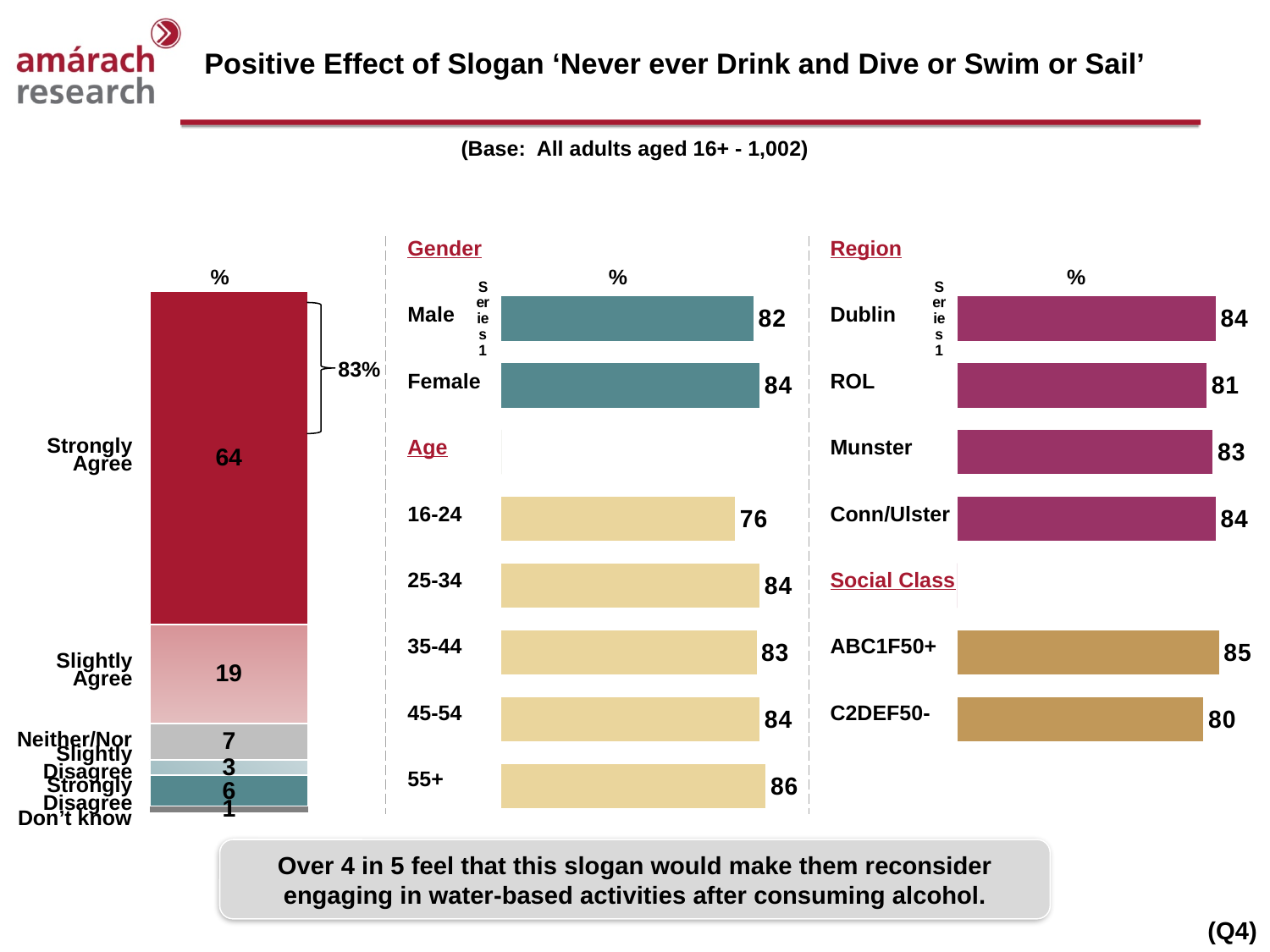
In the Age chart, what is the difference between the values for 55+ and 16-24? 10 In the stacked bar chart on the left, what is the value for Strongly Agree? 64 In the Gender chart, which of Male or Female has the larger value? Female In the Gender chart, what is the value for Female? 84 What type of chart is used for the Region breakdown? Bar chart In the stacked bar chart on the left, what is the value for Slightly Disagree? 3 In the Social Class chart, what is the difference between ABC1F50+ and C2DEF50-? 5 In the Age chart, which age group has the lowest value? 16-24 In the Age chart, which age group has the highest value? 55+ In the Region chart, which region has the lowest value? ROL In the Region chart, what is the value for ROL? 81 How many age groups are shown in the Age chart? 5